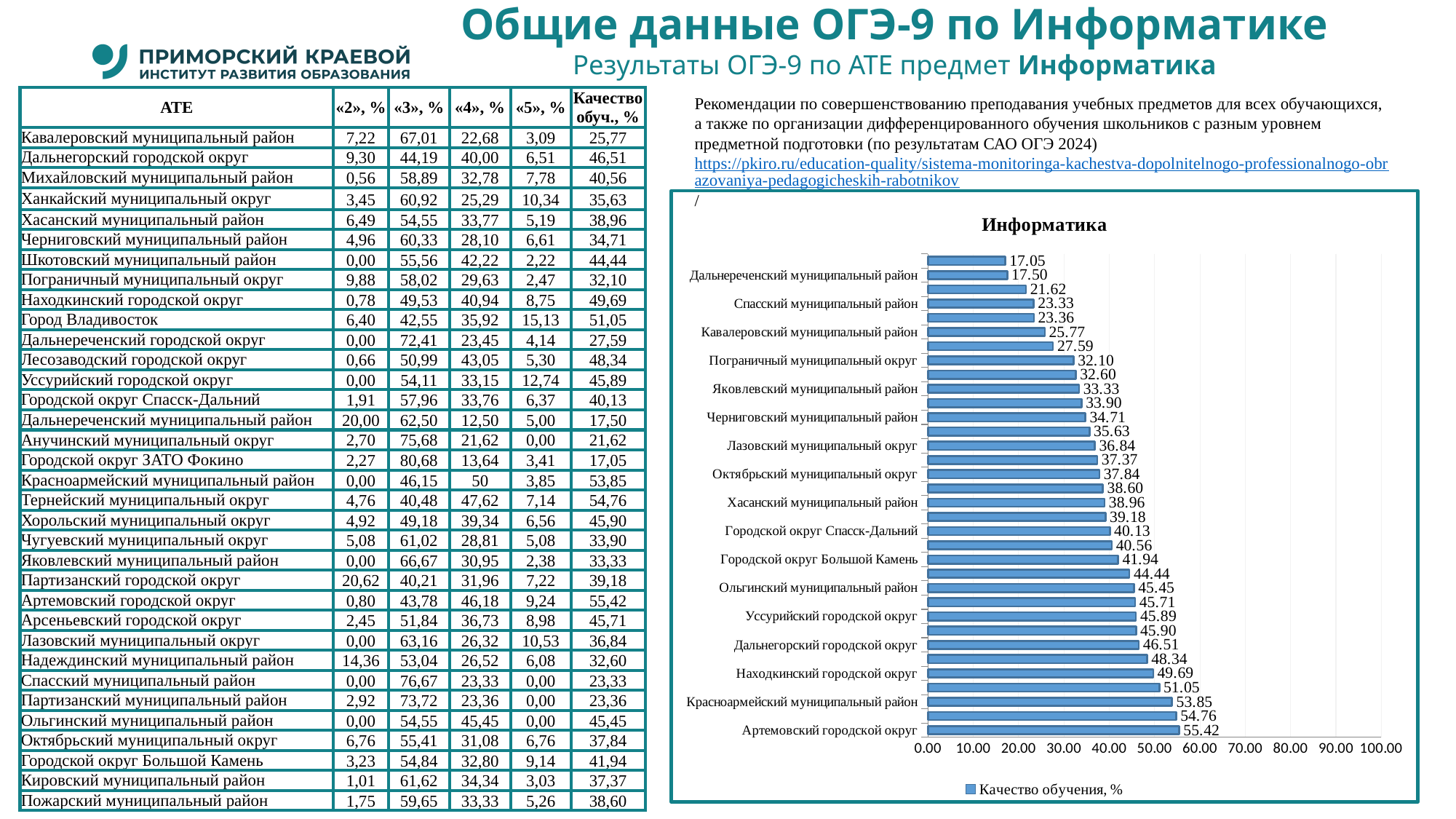
What is the lowest value shown in the "Информатика" chart? 17.05 In the "Информатика" chart, which is larger: the value for Находкинский городской округ or Дальнегорский городской округ? Находкинский городской округ How many series does the legend of the "Информатика" chart list? 1 What type of chart is shown under the title "Информатика"? bar chart What is the legend entry of the "Информатика" chart? Качество обучения, % In the "Информатика" chart, what is the value for Находкинский городской округ? 49.69 In the "Информатика" chart, is the value for Хасанский муниципальный район greater or less than 40.00? less In the "Информатика" chart, what is the difference between the values for Артемовский городской округ and Дальнереченский муниципальный район? 37.92 Which category has the highest value in the "Информатика" chart? Артемовский городской округ In the "Информатика" chart, what is the value for Спасский муниципальный район? 23.33 In the "Информатика" chart, what is the value for Артемовский городской округ? 55.42 In the "Информатика" chart, do the bar values increase or decrease going from the top of the chart to the bottom? increase